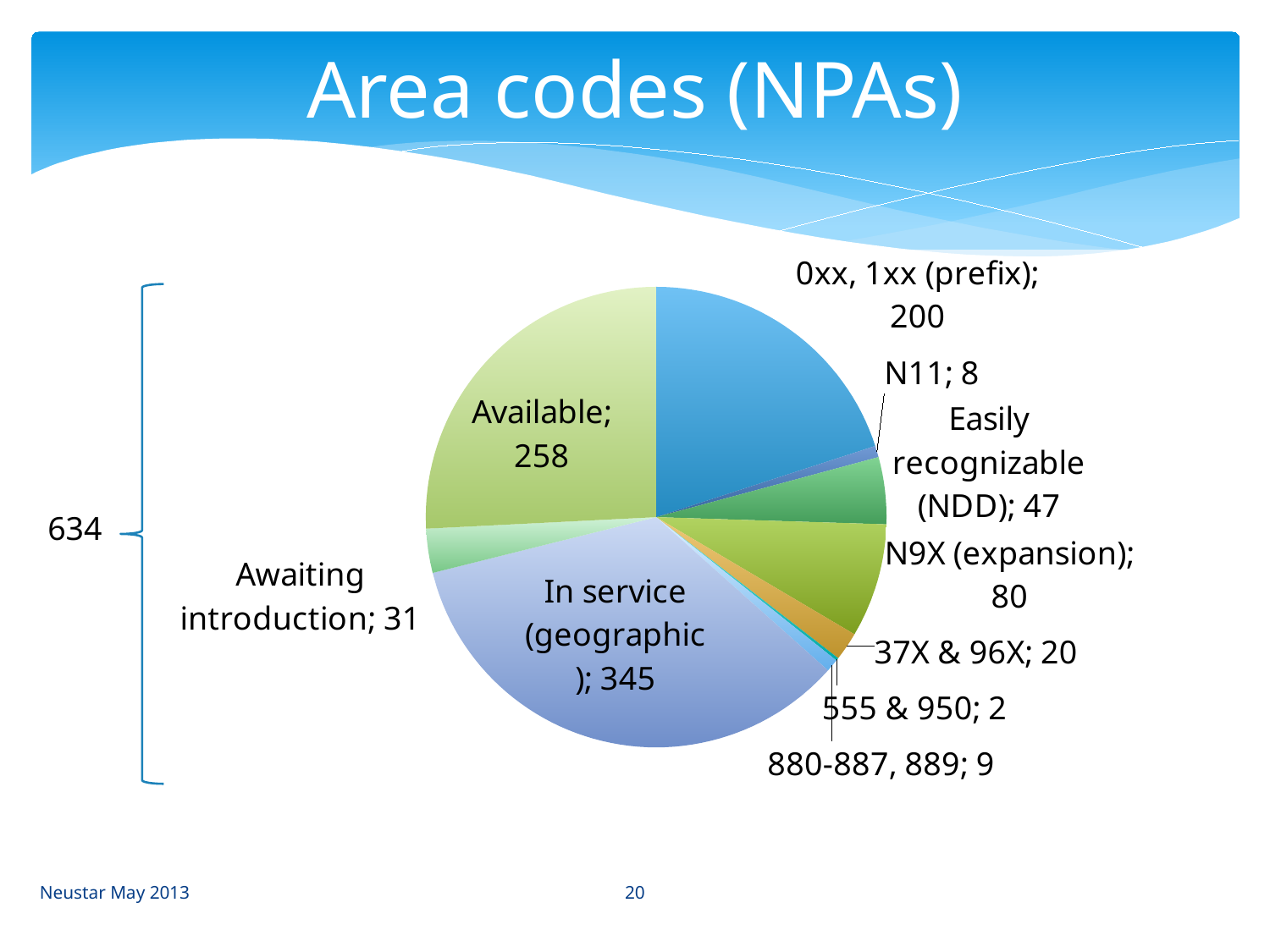
What is the title of the slide containing the pie chart? Area codes (NPAs) What is the difference between the 'In service (geographic)' value and the 'Available' value? 87 What is the value for the 'Easily recognizable (NDD)' slice? 47 What is the value for the 'In service (geographic)' slice? 345 What is the value for the '0xx, 1xx (prefix)' slice? 200 Which is larger, the value for 'N9X (expansion)' or the value for 'Easily recognizable (NDD)'? N9X (expansion) Which category has the largest slice of the pie? In service (geographic) How many slices does the pie chart have? 10 Which category has the smallest slice of the pie? 555 & 950 What type of chart is shown on the slide? pie chart What is the value for the 'Available' slice? 258 What is the value for the 'N9X (expansion)' slice? 80